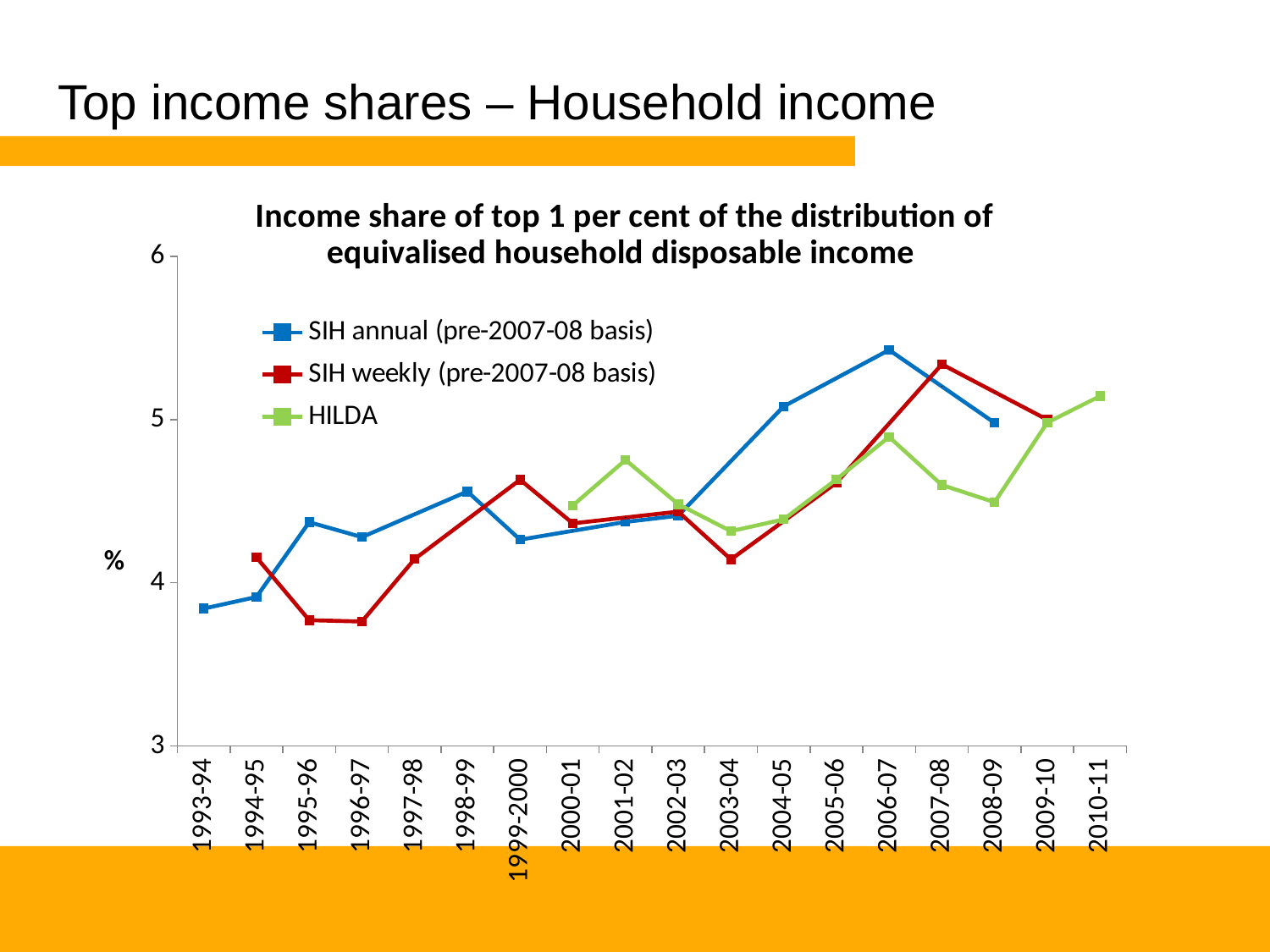
What is the title of the chart? Income share of top 1 per cent of the distribution of equivalised household disposable income In which year does the SIH annual (pre-2007-08 basis) series reach its highest value? 2006-07 Is the value for SIH weekly (pre-2007-08 basis) in 1995-96 greater or less than 4? less Is the value for SIH annual (pre-2007-08 basis) in 2006-07 greater or less than 5? greater How many financial years are shown along the x axis? 18 Which series is shown in green in the legend? HILDA Does the SIH annual (pre-2007-08 basis) series generally rise or fall from 1993-94 to 2008-09? Rise How many series does the legend list? 3 In which year does the HILDA series reach its highest value? 2010-11 What kind of chart is shown on the slide? Line chart In which year is the SIH annual (pre-2007-08 basis) series at its lowest value? 1993-94 In 1995-96, which is larger: SIH annual (pre-2007-08 basis) or SIH weekly (pre-2007-08 basis)? SIH annual (pre-2007-08 basis)